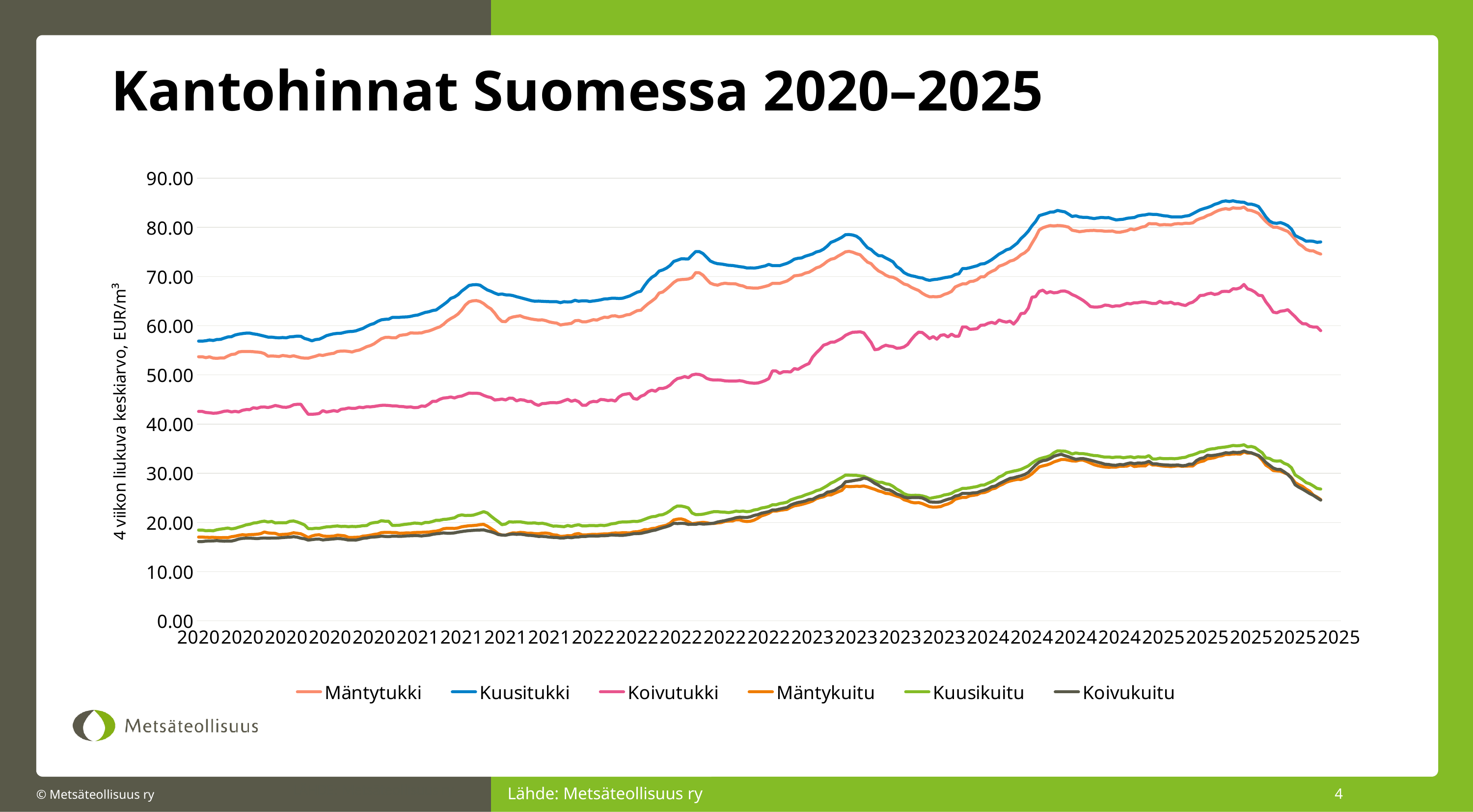
Which series has the highest values across the whole period? Kuusitukki Among Mäntykuitu, Kuusikuitu and Koivukuitu, which series is the highest? Kuusikuitu Is the value for Kuusikuitu at the end of 2025 greater or less than 30? less How many series does the legend list? 6 What is the label on the vertical axis? 4 viikon liukuva keskiarvo, EUR/m³ Is the value for Mäntytukki at the start of 2020 greater or less than 50? greater Is the value for Koivutukki at the start of 2020 greater or less than 50? less Which is larger at the end of the period, Koivutukki or Kuusikuitu? Koivutukki What kind of chart is shown on the slide? line chart What is the title of the chart? Kantohinnat Suomessa 2020–2025 Does the Koivutukki series generally rise or fall from 2020 to 2024? rise